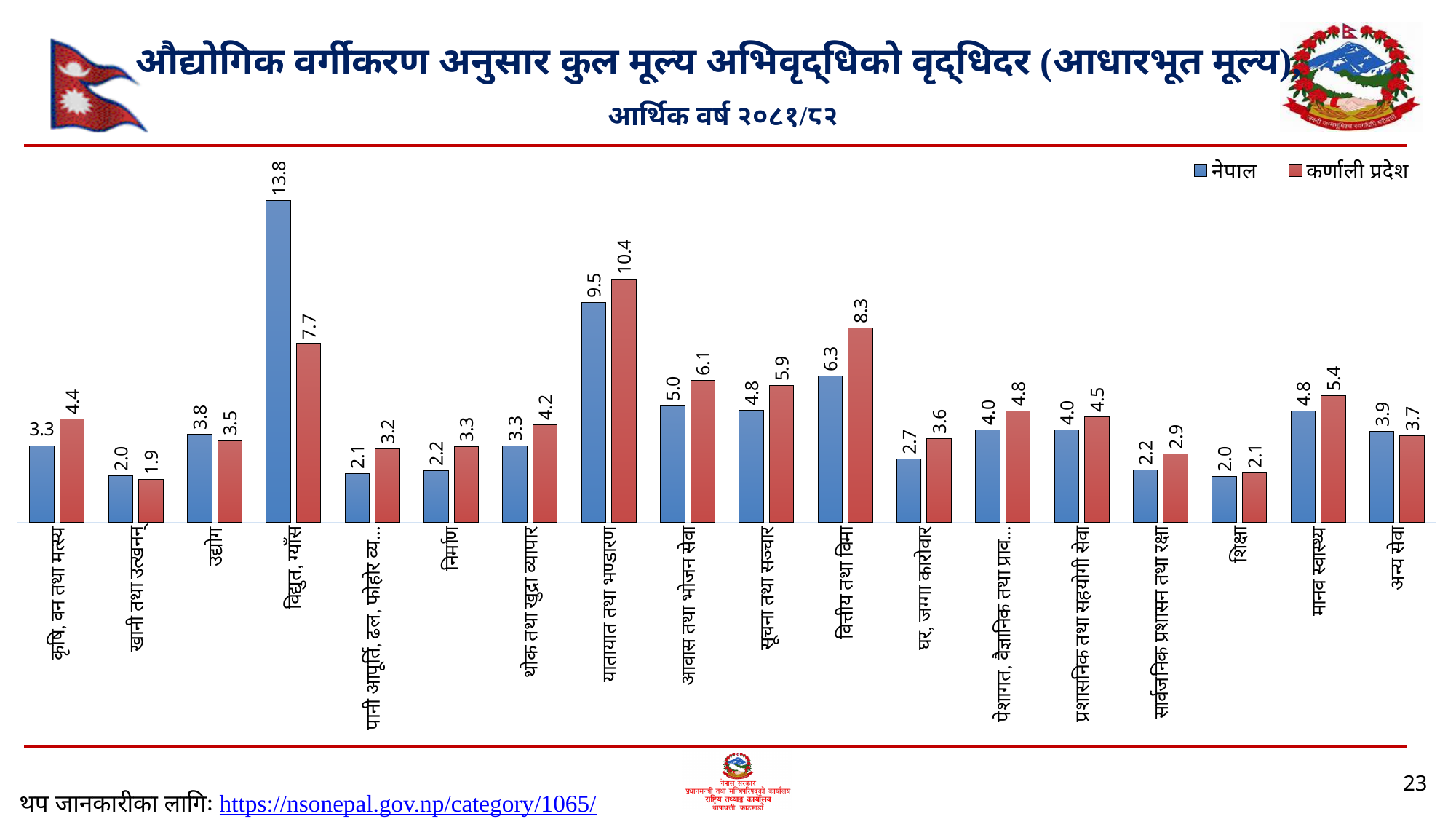
How many series does the legend list? 2 How many categories are shown on the x axis of the chart? 18 What is the value for कर्णाली प्रदेश in the वित्तीय तथा बिमा category? 8.3 What kind of chart is shown on the slide? Bar chart What is the difference between the नेपाल and कर्णाली प्रदेश values in the विद्युत, ग्याँस category? 6.1 What is the value for नेपाल in the विद्युत, ग्याँस category? 13.8 Which colour represents कर्णाली प्रदेश in the chart? Red Which category has the lowest value for कर्णाली प्रदेश? खानी तथा उत्खनन् Which category has the highest value for नेपाल? विद्युत, ग्याँस Which is larger in the आवास तथा भोजन सेवा category: the value for नेपाल or for कर्णाली प्रदेश? कर्णाली प्रदेश What is the value for कर्णाली प्रदेश in the यातायात तथा भण्डारण category? 10.4 Which is larger in the उद्योग category: the value for नेपाल or for कर्णाली प्रदेश? नेपाल